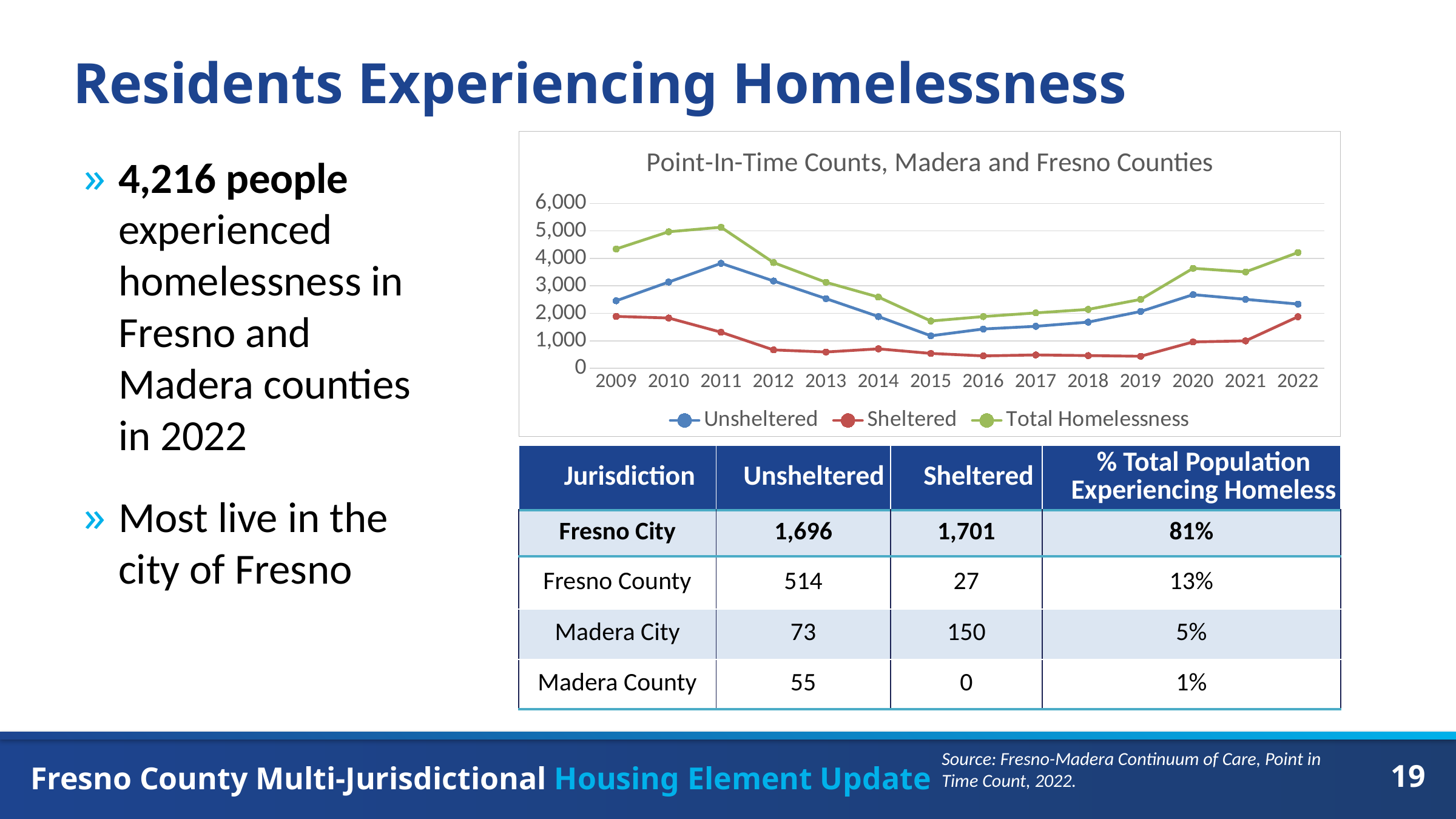
How many years are plotted along the x axis of the chart? 14 In which year is the Unsheltered series at its highest? 2011 In which year is the Total Homelessness series at its lowest? 2015 What is the title of the chart? Point-In-Time Counts, Madera and Fresno Counties In 2022, which is larger, the Unsheltered value or the Sheltered value? Unsheltered In which year is the Unsheltered series at its lowest? 2015 Is the Sheltered value for 2012 greater or less than 1,000? less Which series in the chart is drawn in green? Total Homelessness Does the Total Homelessness series rise or fall from 2015 to 2022? rise Is the Total Homelessness value for 2022 greater or less than 4,000? greater What kind of chart is shown on the slide? line chart How many series does the chart legend list? 3